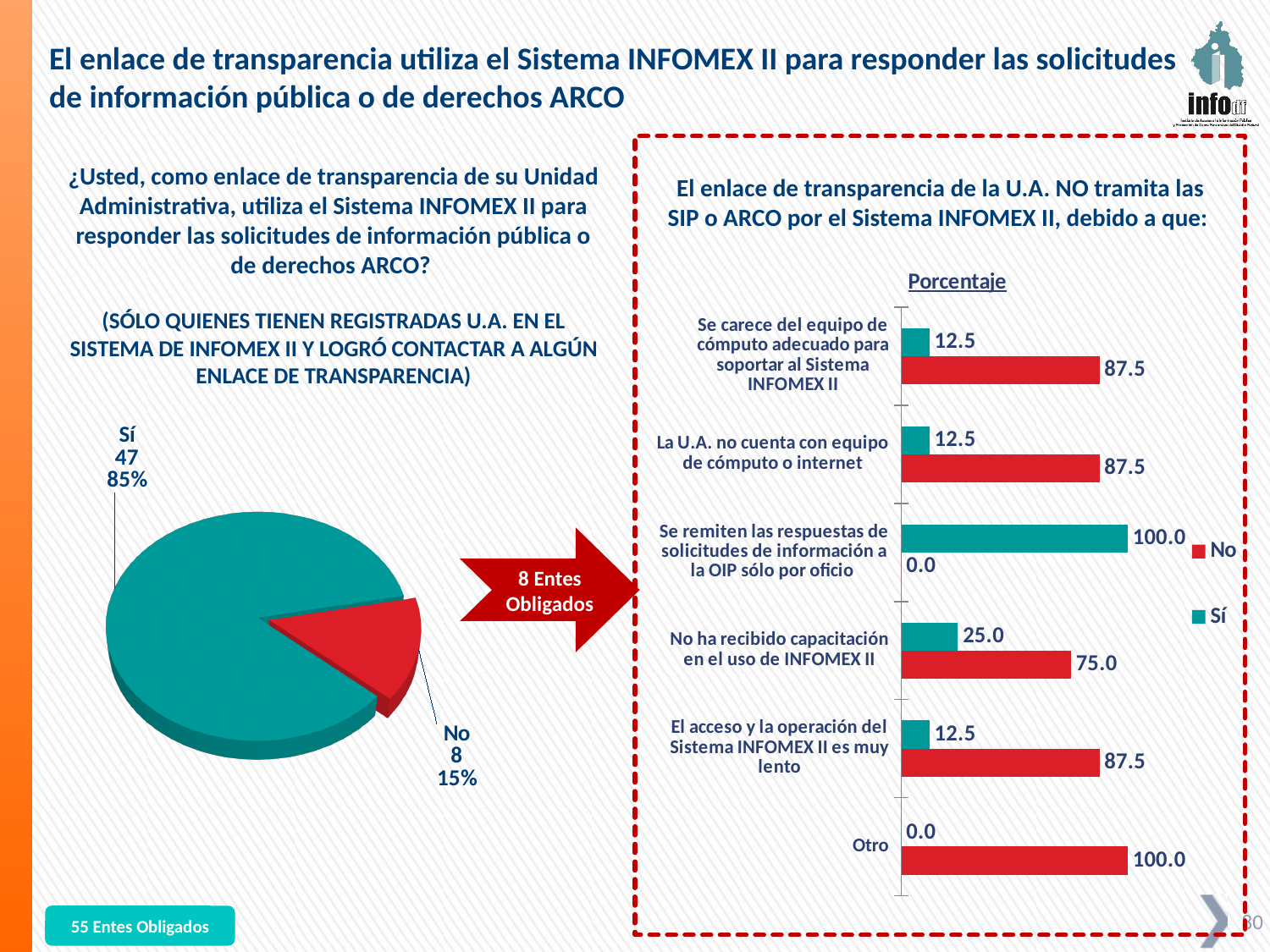
In the bar chart on the right, what is the difference between the "No" and "Sí" values for "La U.A. no cuenta con equipo de cómputo o internet"? 75.0 What type of chart is shown inside the red dashed box on the right? Bar chart In the pie chart on the left, what percentage share does the "No" slice represent? 15% In the pie chart on the left, which slice is larger, "Sí" or "No"? Sí In the bar chart on the right, what is the "Sí" value for "No ha recibido capacitación en el uso de INFOMEX II"? 25.0 In the pie chart on the left, how many respondents answered "Sí"? 47 In the bar chart on the right, what is the "No" value for "Otro"? 100.0 In the bar chart on the right, which category has the highest "Sí" value? Se remiten las respuestas de solicitudes de información a la OIP sólo por oficio In the pie chart on the left, what is the difference between the number of "Sí" and "No" responses? 39 What type of chart is shown on the left side of the slide? Pie chart In the bar chart on the right, how many categories are shown? 6 In the bar chart on the right, how many series does the legend list? 2